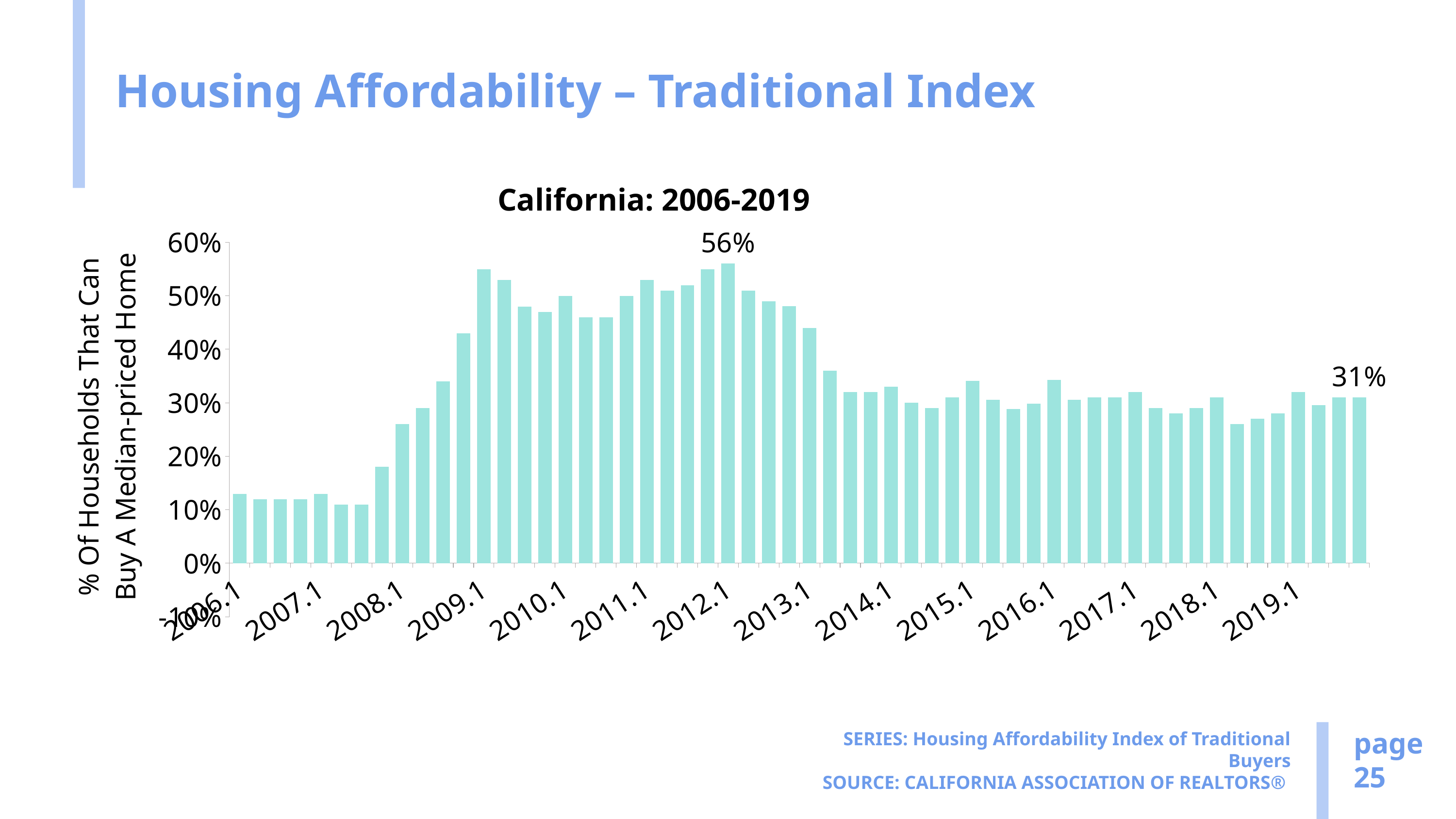
Is the value for 2010.1 greater or less than 40%? greater Do the values rise or fall from 2013.1 to 2014.1? fall What is the title of the chart? California: 2006-2019 Is the value for 2006.1 greater or less than 20%? less What kind of chart is shown on the slide? bar chart Which is larger, the value for 2006.1 or the value for 2019.1? 2019.1 What is the difference between the peak labeled value of 56% and the final labeled value of 31%? 25 percentage points Is the value for 2014.1 greater or less than 40%? less What value is labeled on the last bar of the chart? 31% How many year labels are shown on the x axis? 14 Do the values rise or fall from 2008.1 to 2009.1? rise What is the highest value labeled on the chart? 56%